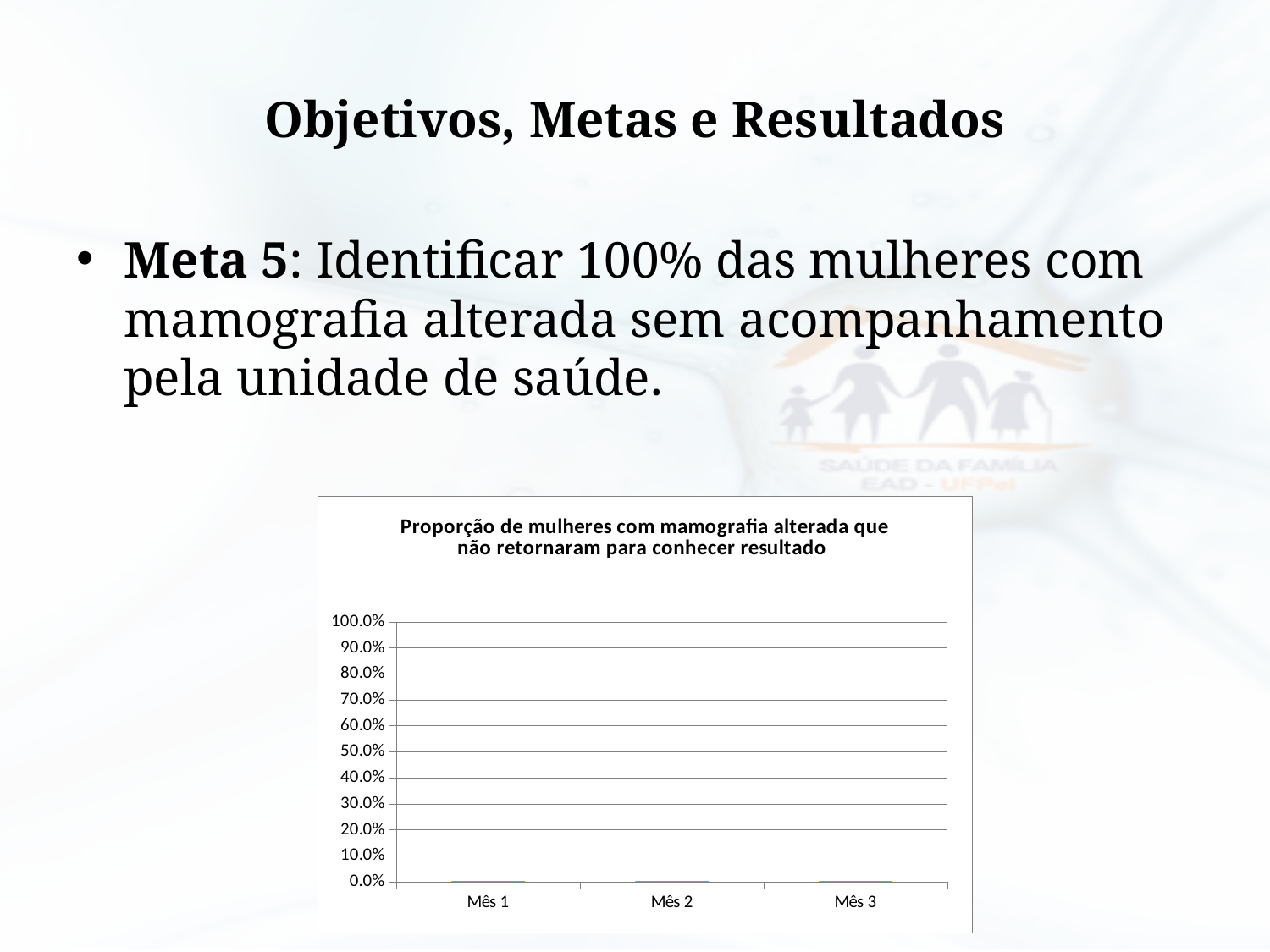
What is the highest value shown on the y axis of the chart? 100.0% What kind of chart is shown on the slide? bar chart Do the values rise, fall or stay flat from Mês 1 to Mês 3? stay flat How many categories are shown on the x axis of the chart? 3 What is the value for Mês 1 in the chart? 0.0% What is the title of the chart? Proporção de mulheres com mamografia alterada que não retornaram para conhecer resultado Is the value for Mês 1 greater or less than 10.0%? less What is the value for Mês 2 in the chart? 0.0% What is the value for Mês 3 in the chart? 0.0% Is the value for Mês 3 greater or less than 50.0%? less What is the label of the first category on the x axis? Mês 1